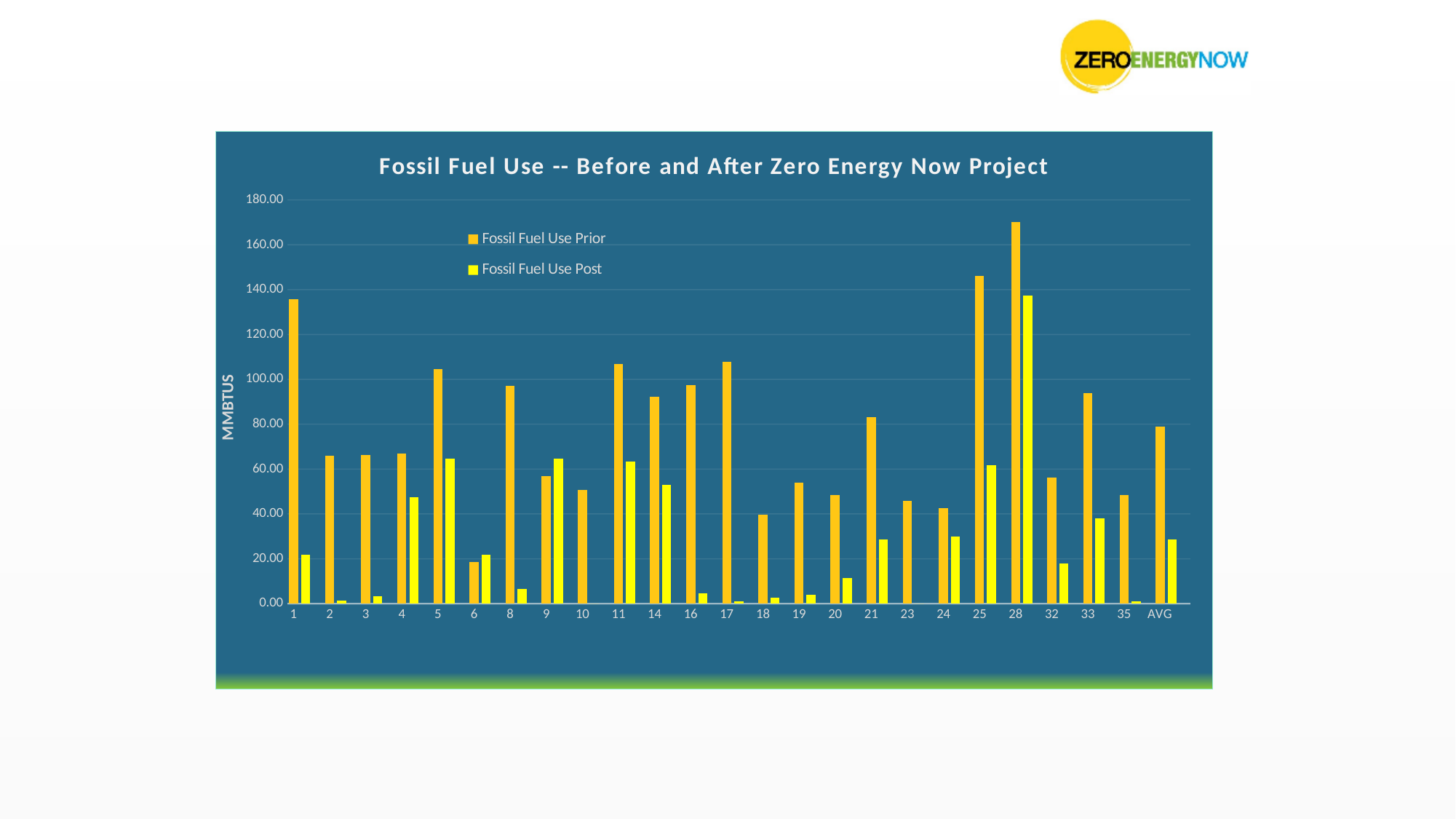
How many categories are shown along the x axis? 25 How many series does the legend list? 2 Which category has the lowest Fossil Fuel Use Prior value? 6 Which category has the highest Fossil Fuel Use Prior value? 28 What is the label on the vertical axis? MMBTUS What is the title of the chart? Fossil Fuel Use -- Before and After Zero Energy Now Project What kind of chart is shown on the slide? bar chart Which is larger, the Fossil Fuel Use Prior value for category 1 or for category 25? category 25 Which category has the highest Fossil Fuel Use Post value? 28 Is the Fossil Fuel Use Post value for category 28 greater or less than 120? greater Is the Fossil Fuel Use Prior value for category 1 greater or less than 120? greater Is the Fossil Fuel Use Post value for AVG greater or less than 40? less